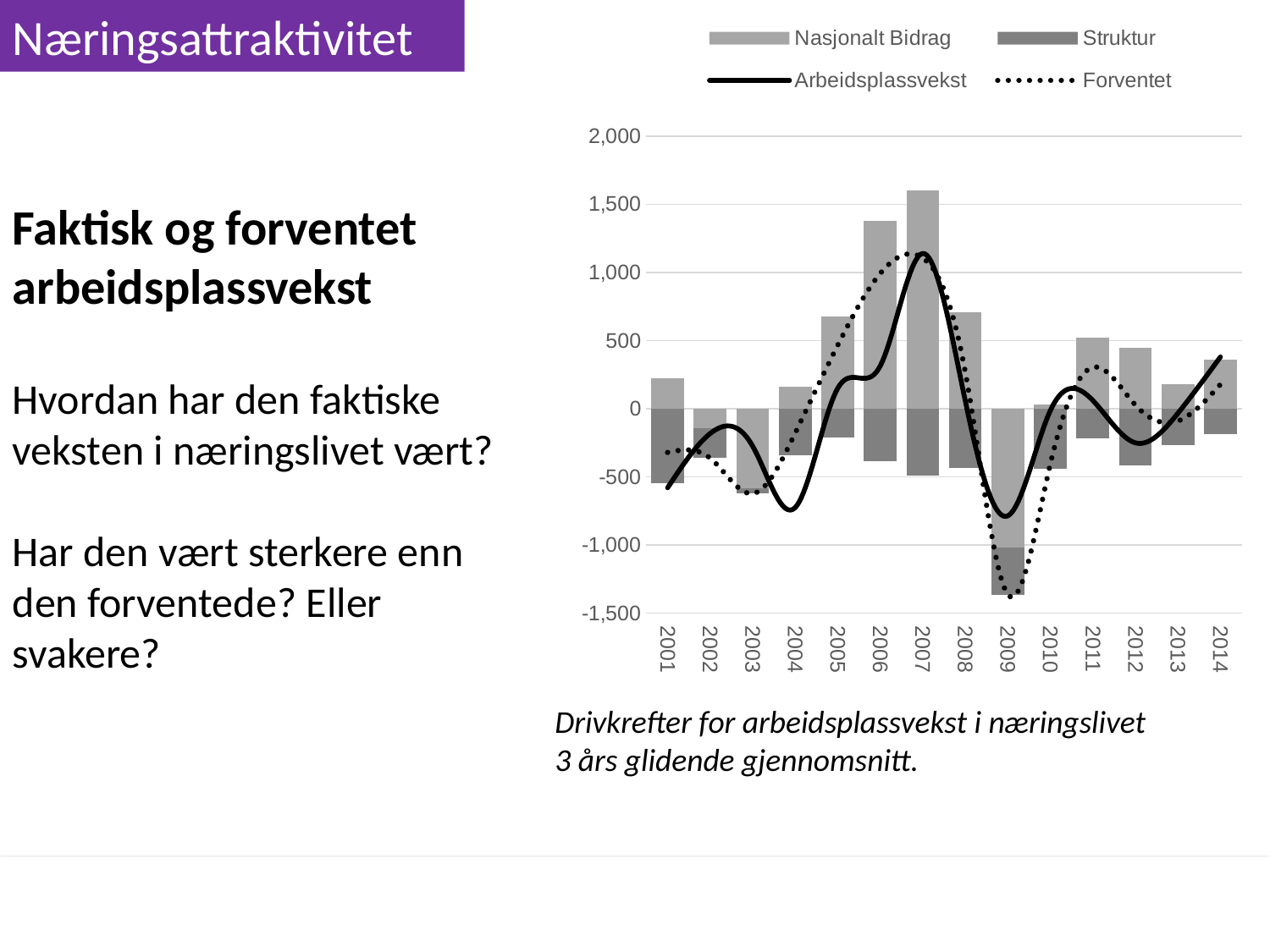
How many years are shown on the x axis of the chart? 14 How many series does the chart legend list? 4 Is the Forventet value for 2009 greater or less than -1,000? less Is the Nasjonalt Bidrag value for 2009 greater or less than -500? less Is the Nasjonalt Bidrag value for 2006 greater or less than 1,000? greater Which series in the legend is drawn as a dotted line? Forventet What kind of chart is shown on the slide? A combined bar and line chart In which year is the Nasjonalt Bidrag bar lowest? 2009 Which is larger, the Nasjonalt Bidrag bar for 2006 or for 2007? 2007 In which year is the Nasjonalt Bidrag bar highest? 2007 Does the Arbeidsplassvekst line rise or fall from 2004 to 2007? rise